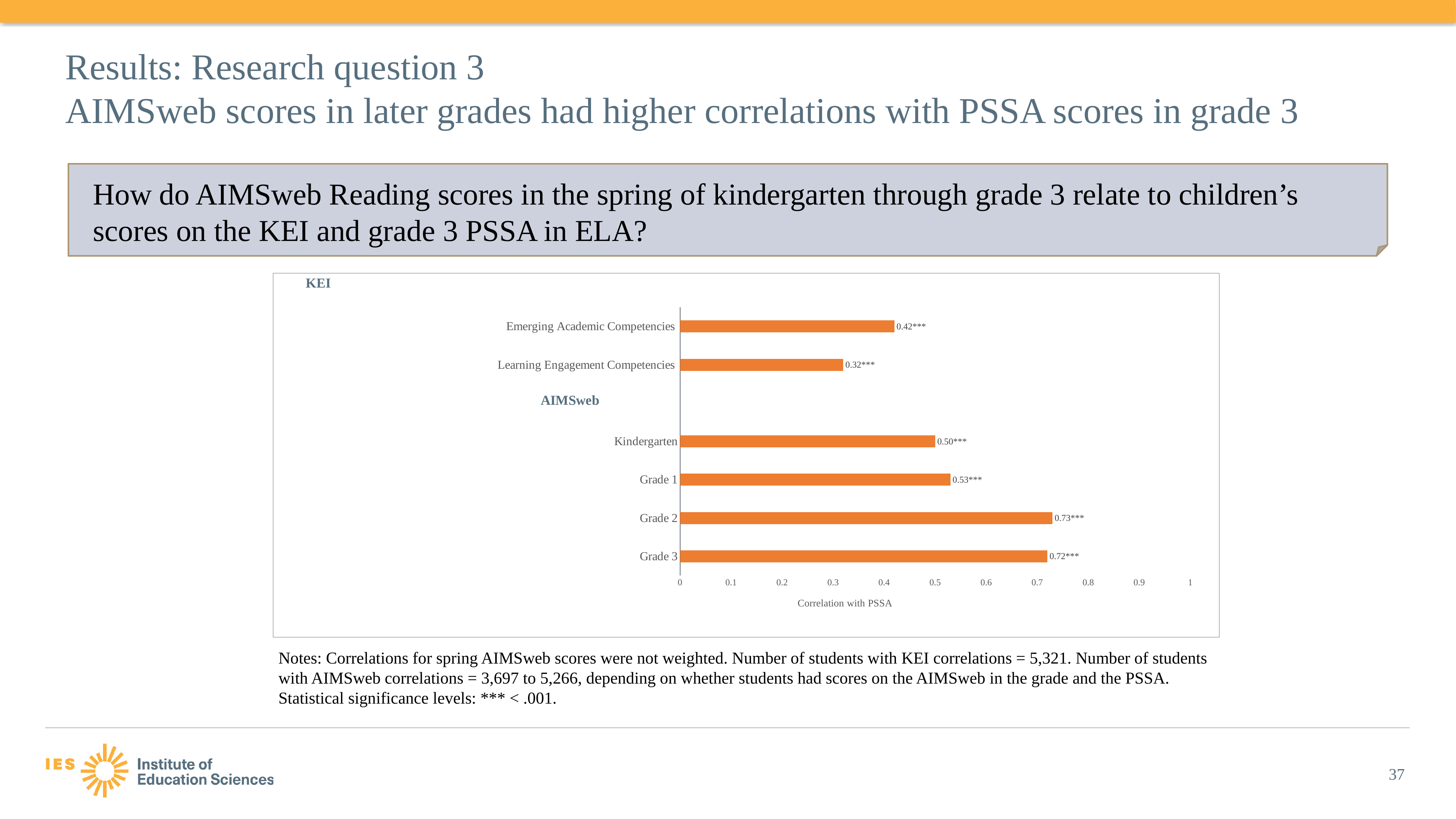
How many bars are plotted in the chart? 6 What is the difference between the correlation for Grade 2 and the correlation for Kindergarten? 0.23 Which category has the lowest correlation with PSSA? Learning Engagement Competencies Which has a larger correlation with PSSA, Grade 1 or Emerging Academic Competencies? Grade 1 What is the correlation with PSSA for Grade 2? 0.73*** Is the correlation for Grade 3 greater or less than 0.6? greater What is the correlation with PSSA for the Kindergarten AIMSweb score? 0.50*** Which category has the highest correlation with PSSA? Grade 2 What kind of chart is shown on the slide? Bar chart What is the correlation with PSSA for Learning Engagement Competencies? 0.32*** What is the correlation with PSSA for Emerging Academic Competencies? 0.42*** What is the label of the horizontal axis of the chart? Correlation with PSSA